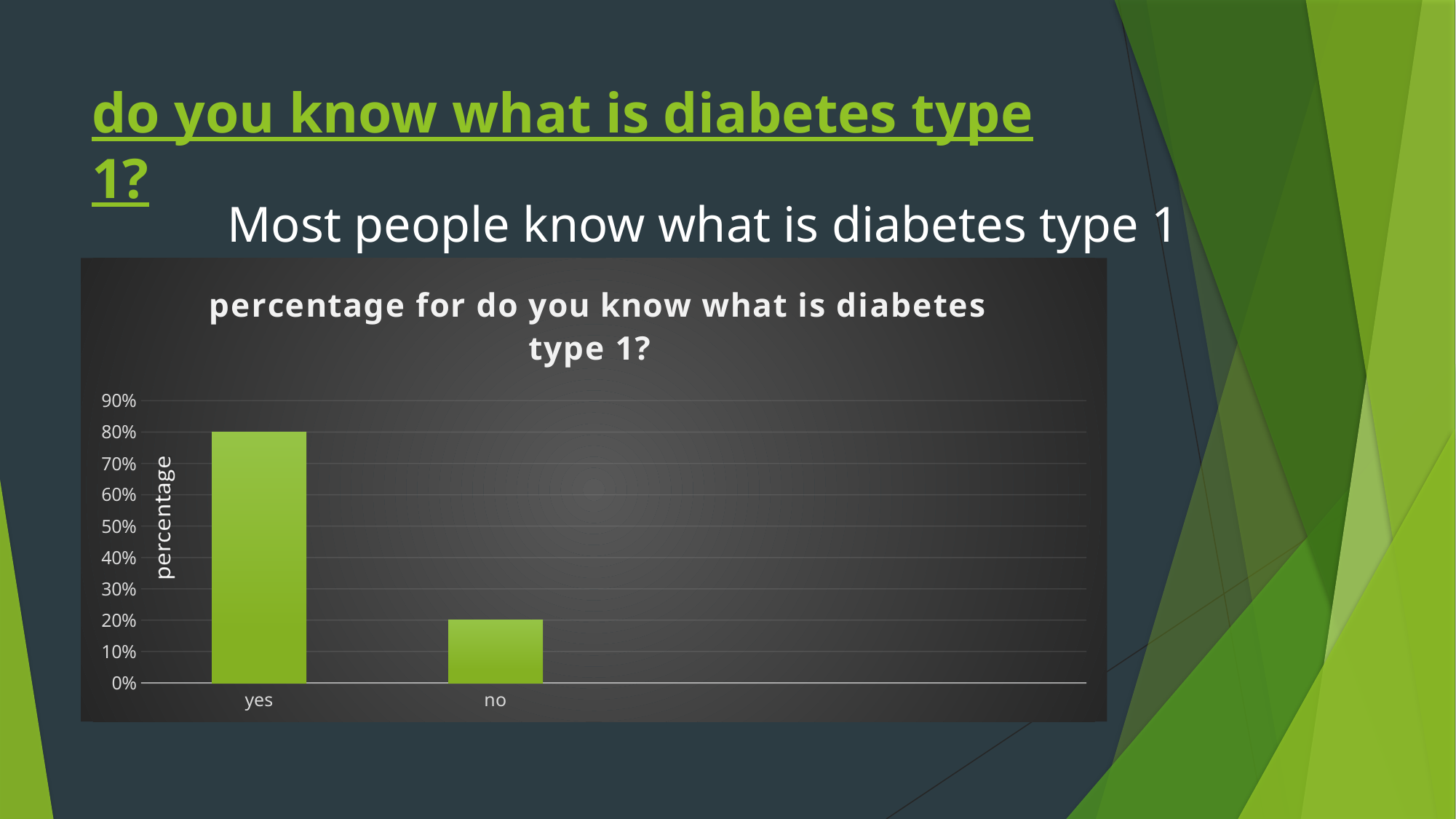
Which category has the highest value? yes Is the value for "no" greater or less than 30%? less Which category has the lowest value? no What type of chart is shown on the slide? bar chart What is the value for "yes"? 80% What is the label on the vertical axis of the chart? percentage What is the value for "no"? 20% What is the difference between the values for "yes" and "no"? 60% Which is larger, the value for "yes" or the value for "no"? yes How many categories are plotted in the chart? 2 What is the title of the chart? percentage for do you know what is diabetes type 1? Is the value for "yes" greater or less than 50%? greater